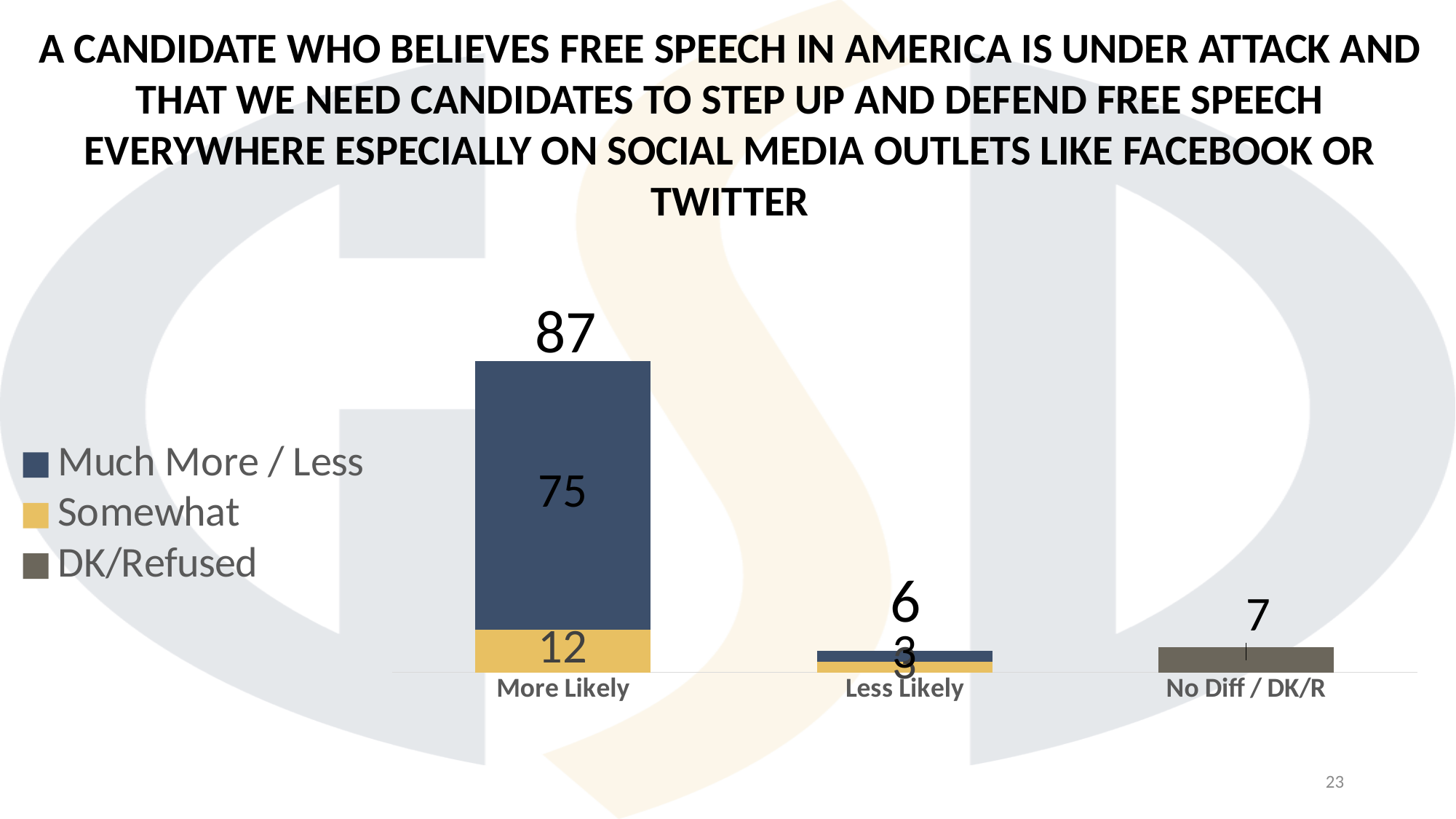
What type of chart is shown on the slide? Stacked bar chart What is the value for No Diff / DK/R? 7 How many series does the legend list? 3 What is the total value of the Less Likely bar? 6 How many categories are shown on the x axis of the chart? 3 Which category has the lowest total value? Less Likely What is the Much More / Less value for More Likely? 75 What is the total value of the More Likely bar? 87 What is the Somewhat value for More Likely? 12 Which legend entry is shown in gold/yellow? Somewhat What is the difference between the Much More / Less and Somewhat values for More Likely? 63 Which category has the highest total value? More Likely